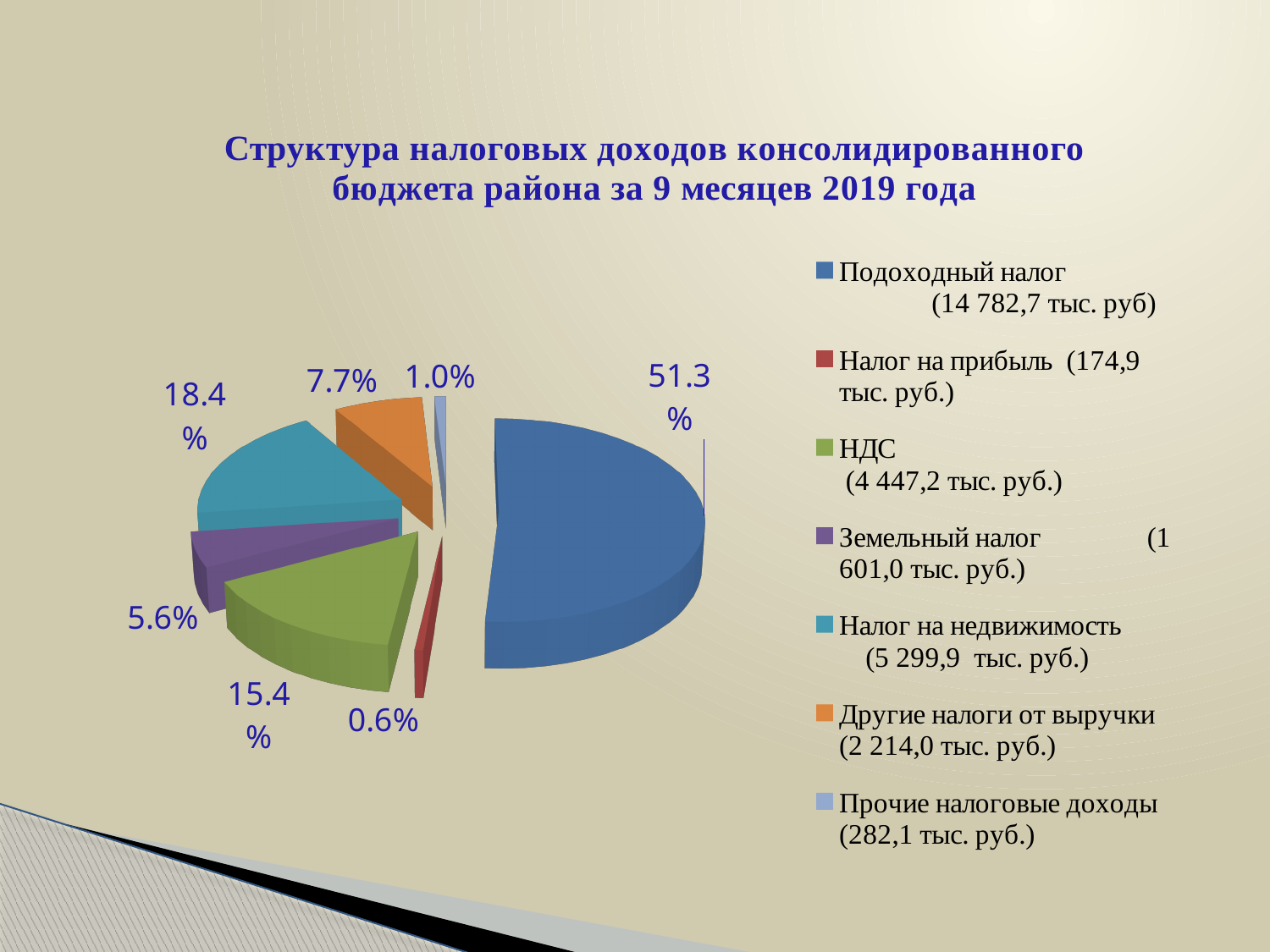
What share of the pie does Подоходный налог represent? 51.3% Which category has the smallest slice of the pie? Налог на прибыль According to the legend, what amount in тыс. руб. is given for Земельный налог? 1 601,0 тыс. руб. What type of chart is shown on the slide? Pie chart What percentage is shown for Налог на прибыль? 0.6% Which category has the largest slice of the pie? Подоходный налог Which is larger, the share for Другие налоги от выручки or the share for Земельный налог? Другие налоги от выручки What share of the pie does НДС represent? 15.4% How many slices does the pie chart have? 7 What share of the pie does Налог на недвижимость represent? 18.4% What percentage is shown for Прочие налоговые доходы? 1.0% What is the difference in percentage points between Налог на недвижимость and НДС? 3.0